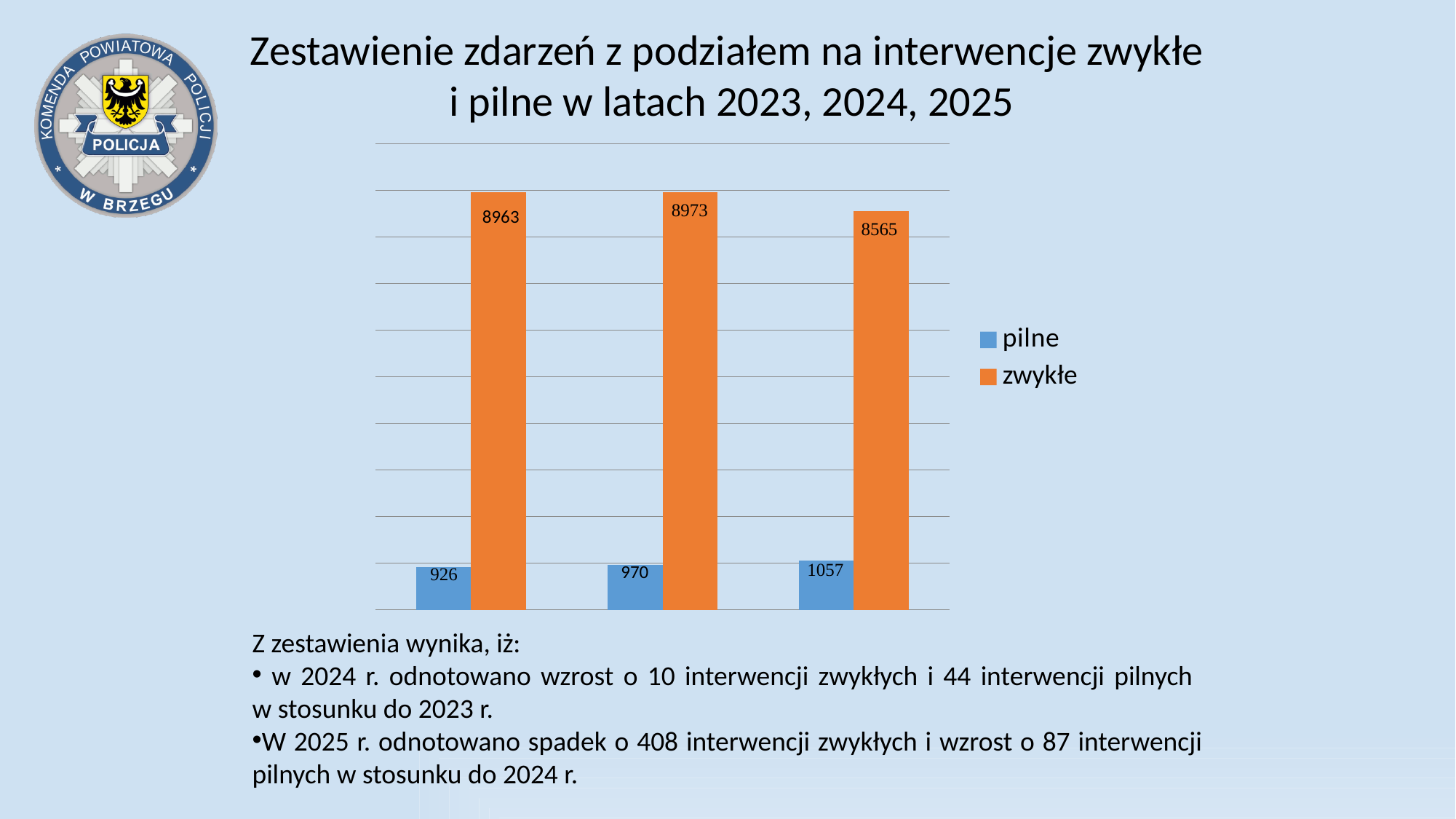
What is the difference between the pilne values of the rightmost group (2025) and the middle group (2024)? 87 What is the value of the pilne bar in the middle group (2024)? 970 Which group has the lowest pilne value? the leftmost group (2023), 926 How many series does the legend list? 2 Do the pilne values rise or fall from the leftmost group to the rightmost group? rise What colour represents the zwykłe series in the legend? orange Which group has the highest zwykłe value? the middle group (2024), 8973 Which is larger: the pilne value in the leftmost group (2023) or in the middle group (2024)? the middle group (2024), 970 What is the value of the zwykłe (orange) bar in the leftmost group (2023)? 8963 What is the value of the pilne (blue) bar in the rightmost group (2025)? 1057 By how much is the zwykłe value in the middle group (2024) greater than in the rightmost group (2025)? 408 What kind of chart is shown on the slide? bar chart